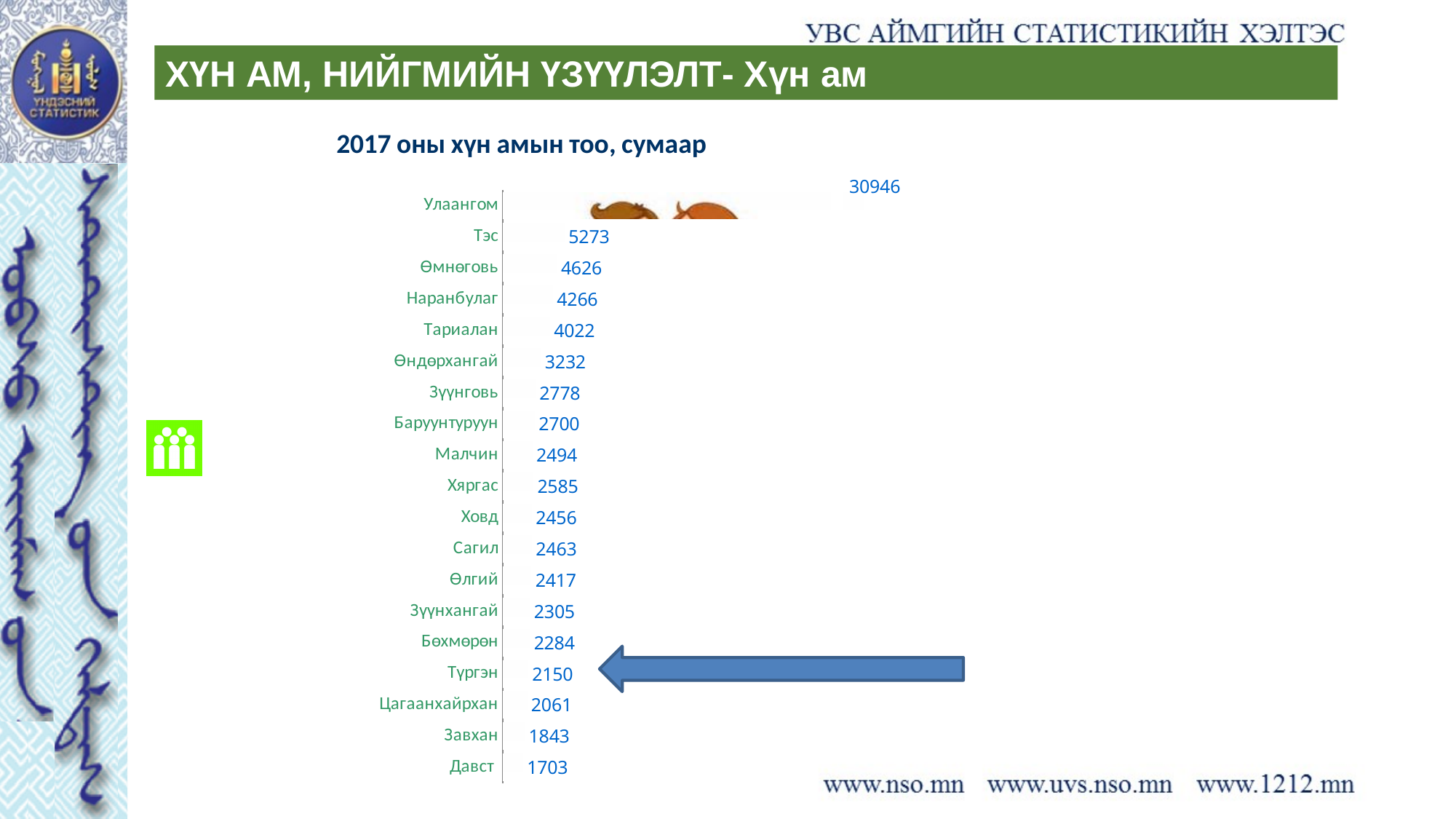
What is the title of the chart? 2017 оны хүн амын тоо, сумаар What is the population value shown for Улаангом? 30946 What is the difference between the values for Тэс and Өмнөговь? 647 How many categories (sums) are shown on the chart? 19 What is the value shown for Тэс? 5273 What is the value shown for Давст? 1703 Which has a larger value, Хяргас or Малчин? Хяргас What is the value shown for Түргэн, the category the arrow points to? 2150 Which category has the highest value on the chart? Улаангом What kind of chart is shown on the slide? Bar chart What is the difference between the values for Завхан and Давст? 140 Which category has the lowest value on the chart? Давст